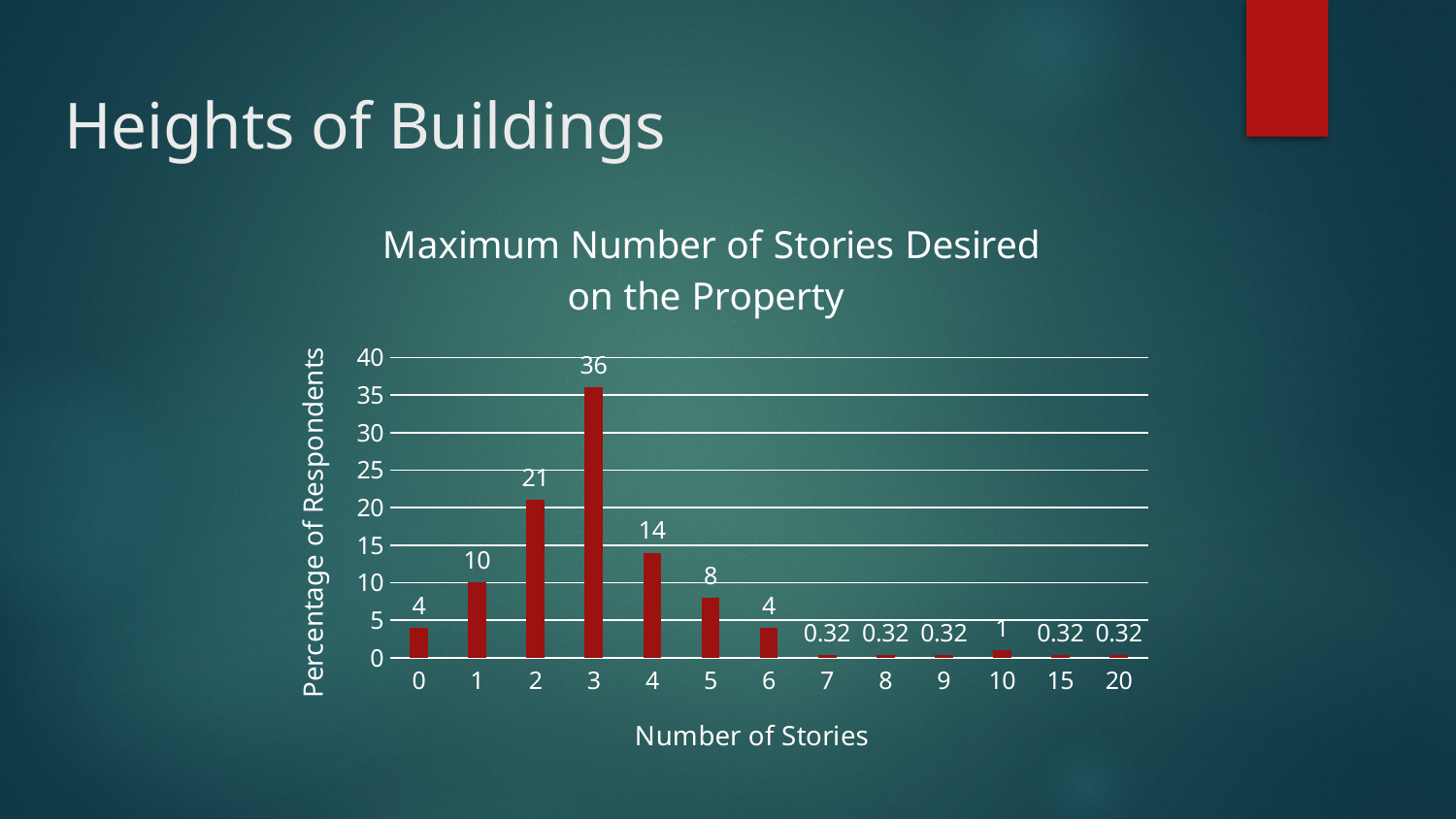
What is the value for 10 stories? 1 How many categories are shown on the x axis? 13 What is the value for 2 stories? 21 Is the value for 3 stories greater or less than 30? greater What is the difference between the values for 3 stories and 2 stories? 15 What kind of chart is shown on the slide? Bar chart What is the title of the chart? Maximum Number of Stories Desired on the Property What percentage of respondents desired a maximum of 3 stories? 36 What is the value for 7 stories? 0.32 Which is larger, the value for 1 story or the value for 4 stories? 4 stories Which number of stories has the highest percentage of respondents? 3 What is the difference between the values for 4 stories and 5 stories? 6